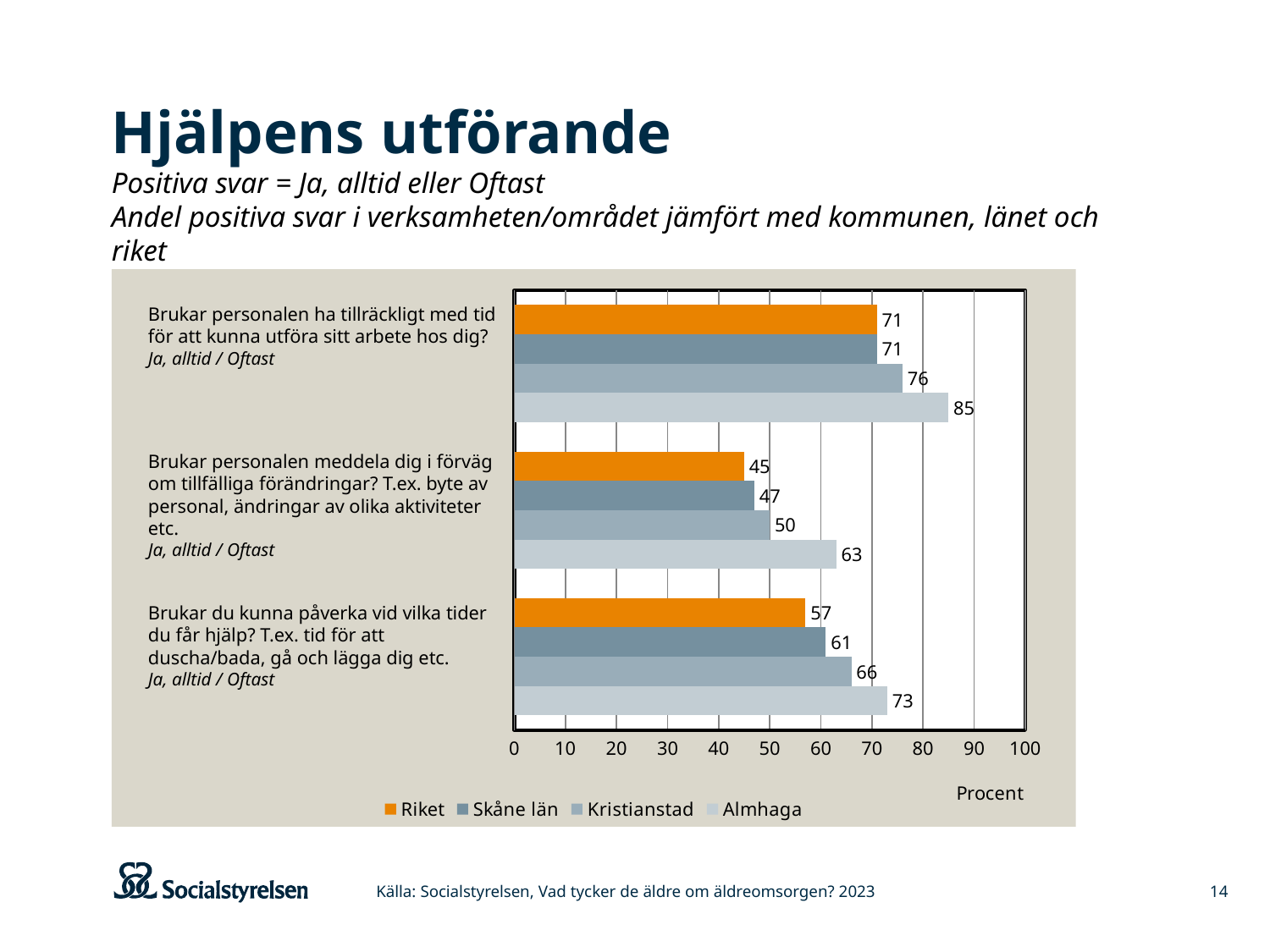
What is the value for Kristianstad on the question "Brukar du kunna påverka vid vilka tider du får hjälp?"? 66 What kind of chart is shown on the slide? Bar chart Which series has the highest value on the question "Brukar personalen meddela dig i förväg om tillfälliga förändringar?"? Almhaga Is the value for Almhaga on the question "Brukar du kunna påverka vid vilka tider du får hjälp?" greater or less than 70? greater How many series does the legend list? 4 What is the value for Riket on the question "Brukar personalen meddela dig i förväg om tillfälliga förändringar?"? 45 What is the value for Skåne län on the question "Brukar du kunna påverka vid vilka tider du får hjälp?"? 61 What is the difference between the Almhaga and Riket values on the question "Brukar personalen ha tillräckligt med tid för att kunna utföra sitt arbete hos dig?"? 14 Which series has the lowest value on the question "Brukar du kunna påverka vid vilka tider du får hjälp?"? Riket What is the value for Almhaga on the question "Brukar personalen ha tillräckligt med tid för att kunna utföra sitt arbete hos dig?"? 85 How many question categories are shown on the chart? 3 Which is larger on the question "Brukar personalen meddela dig i förväg om tillfälliga förändringar?": the value for Kristianstad or the value for Skåne län? Kristianstad